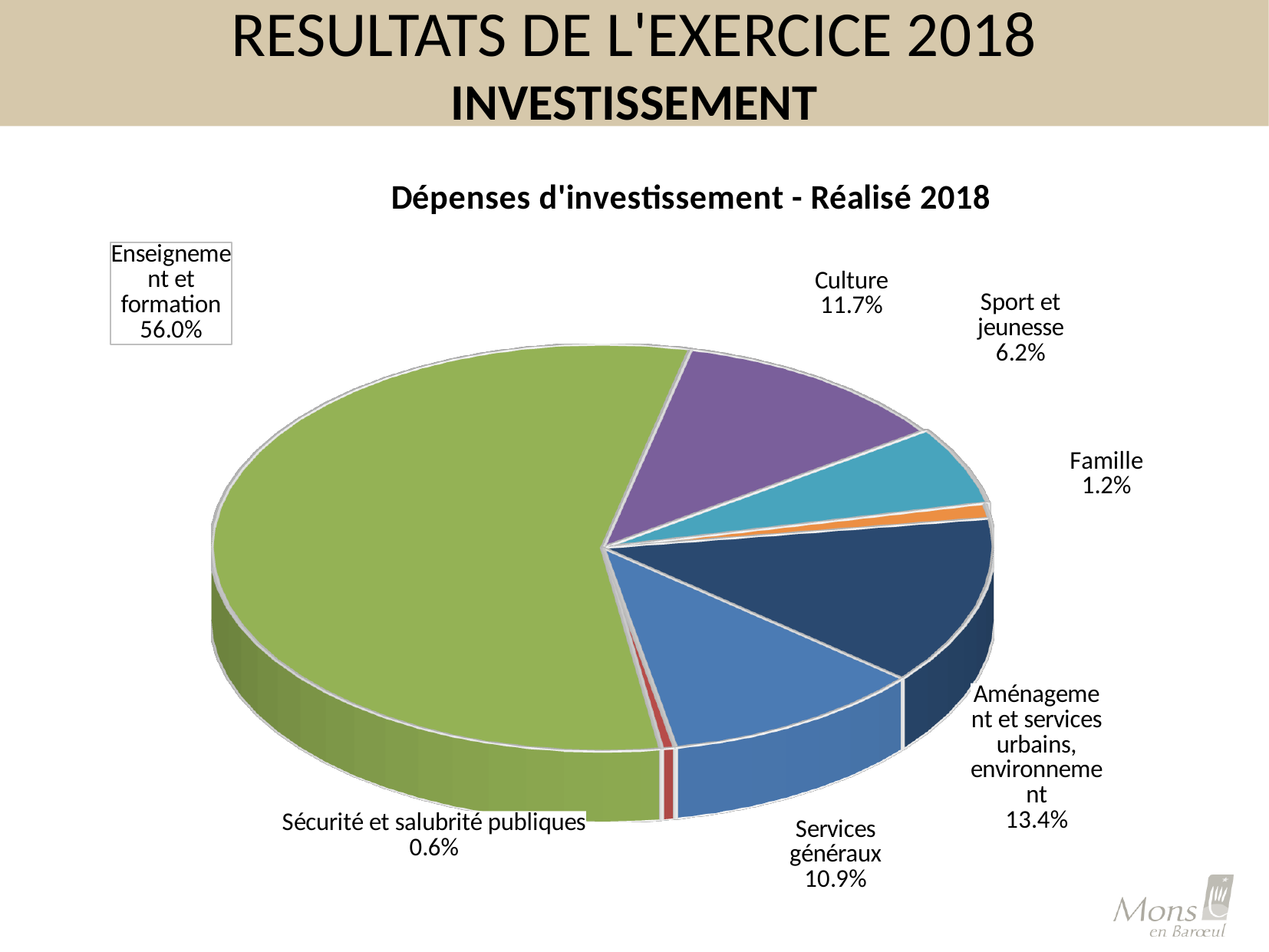
Which category has the largest slice of the pie? Enseignement et formation What is the value shown for Culture? 11.7% What share of the pie does Enseignement et formation represent? 56.0% Which category has the smallest slice of the pie? Sécurité et salubrité publiques What is the value shown for Sport et jeunesse? 6.2% What is the difference between the shares of Culture and Services généraux? 0.8% What is the value shown for Aménagement et services urbains, environnement? 13.4% How many categories are shown in the pie chart? 7 What kind of chart is shown on the slide? Pie chart Which is larger, the share for Famille or the share for Sport et jeunesse? Sport et jeunesse What is the value shown for Services généraux? 10.9% What is the title of the chart? Dépenses d'investissement - Réalisé 2018